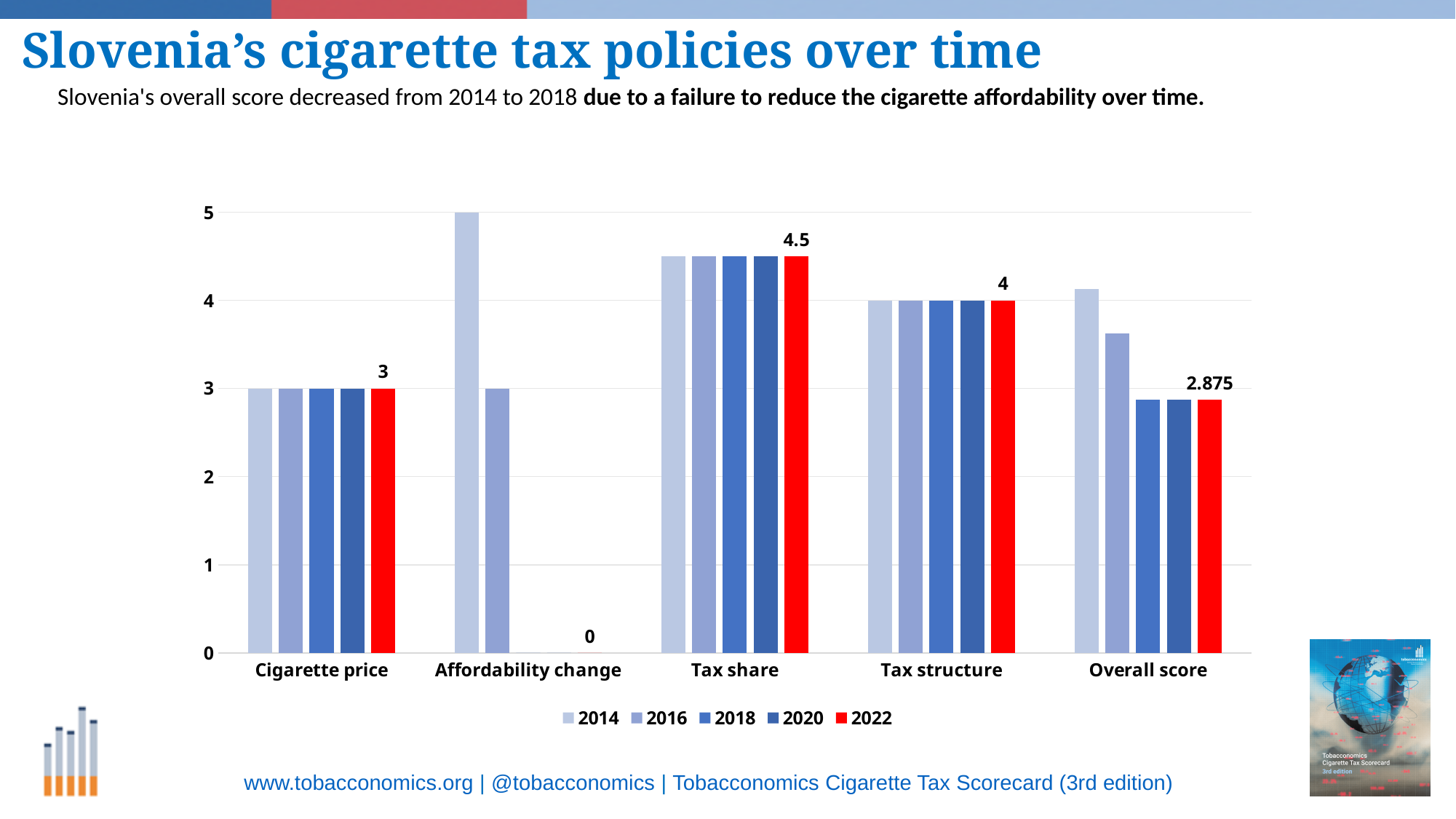
Is the value for Overall score in 2016 greater or less than 4? less What is the difference between the 2022 values for Tax share and Tax structure? 0.5 What kind of chart is shown on the slide? bar chart How many series does the legend list? 5 Which category has the highest value in 2022? Tax share What is the value for Affordability change in 2014? 5 Which category has the lowest value in 2022? Affordability change What is the value for Overall score in 2022? 2.875 What is the value for Affordability change in 2022? 0 Does the Overall score rise or fall from 2014 to 2022? fall Is the value for Overall score in 2014 greater or less than 4? greater What is the value for Tax share in 2022? 4.5